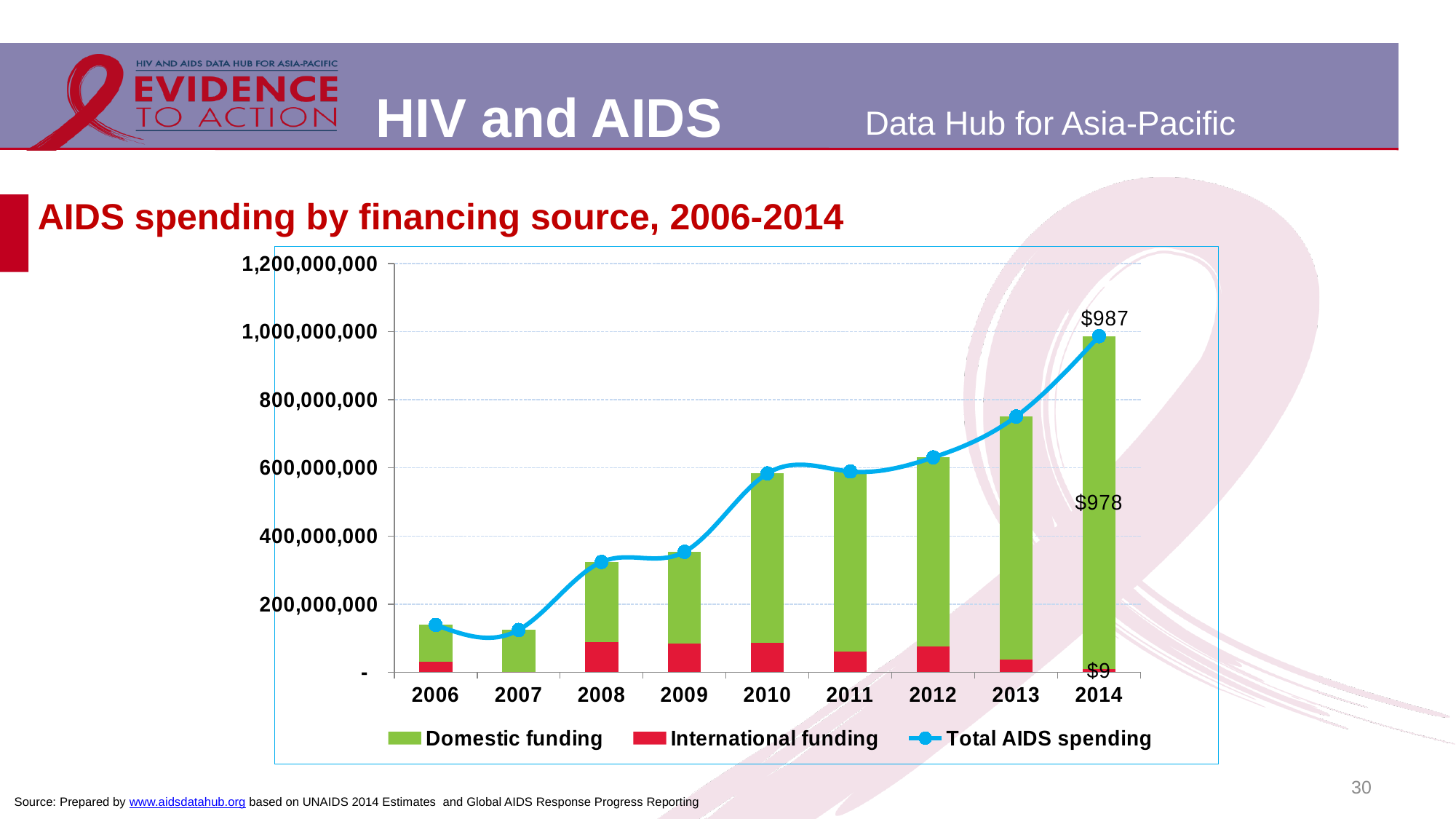
How many years are shown on the x axis of the chart? 9 Does Total AIDS spending generally rise or fall from 2006 to 2014? Rise What is the labelled value of Total AIDS spending in 2014? $987 What is the difference between the labelled Domestic funding and International funding values in 2014? $969 How many series does the legend list? 3 What is the labelled value of Domestic funding in 2014? $978 Is the Total AIDS spending for 2010 greater or less than 400,000,000? greater In which year is Total AIDS spending highest? 2014 What kind of chart is this? A stacked bar chart combined with a line chart Is the Total AIDS spending for 2008 greater or less than 400,000,000? less What is the labelled value of International funding in 2014? $9 Which colour represents Domestic funding in the legend? Green